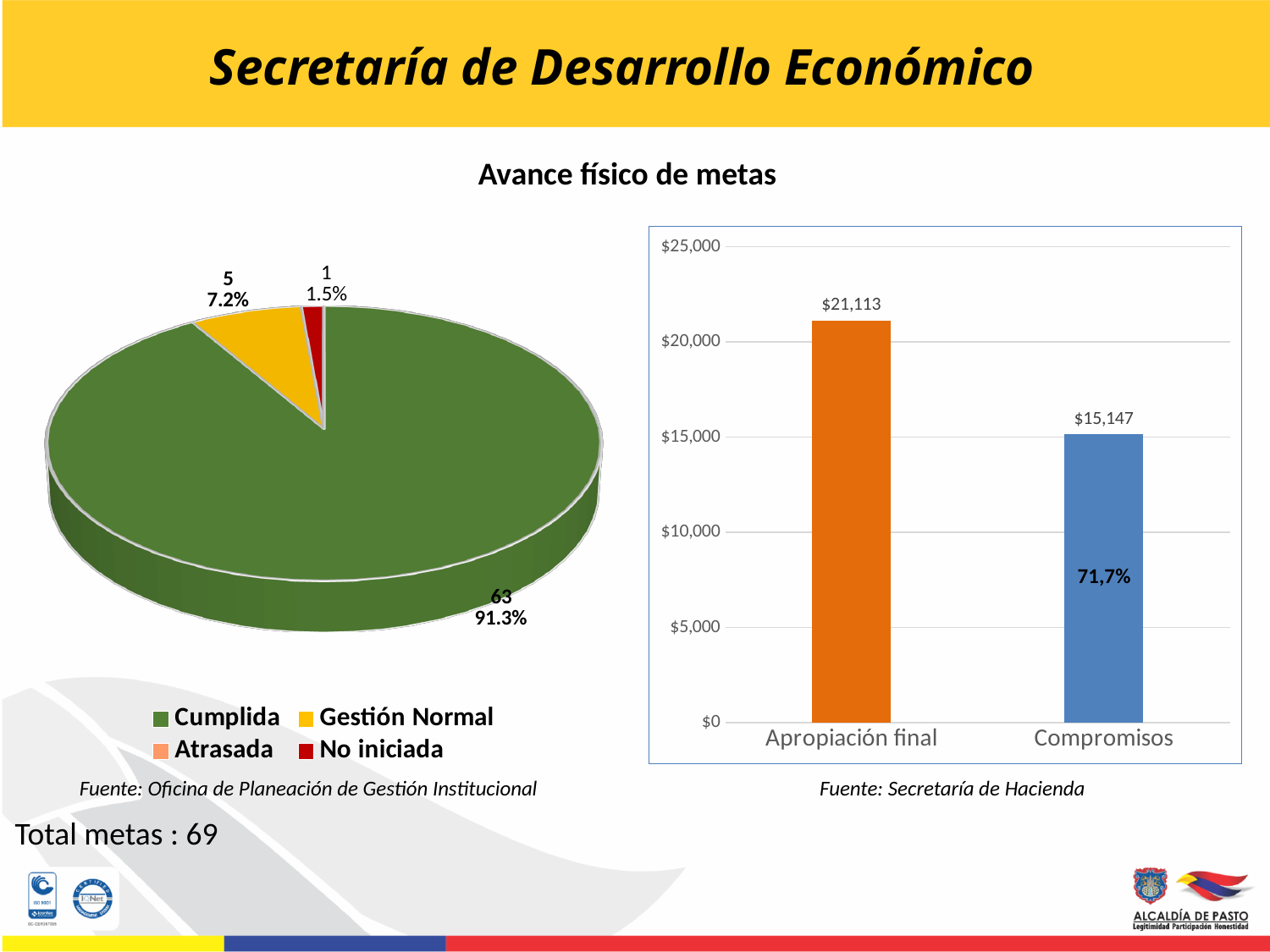
In the bar chart on the right, what is the value for Apropiación final? $21,113 In the bar chart on the right, what is the value for Compromisos? $15,147 In the pie chart on the left, which category has the largest slice? Cumplida In the bar chart on the right, which category has the higher value, Apropiación final or Compromisos? Apropiación final What kind of chart is the chart on the left of the slide? Pie chart In the pie chart on the left, what percentage share does the Cumplida slice have? 91.3% In the bar chart on the right, what is the difference between Apropiación final and Compromisos? $5,966 In the bar chart on the right, what percentage is printed on the Compromisos bar? 71,7% In the pie chart on the left, how many entries does the legend list? 4 In the pie chart on the left, what percentage share does the Gestión Normal slice have? 7.2% In the pie chart on the left, what is the count shown for the No iniciada slice? 1 In the pie chart on the left, how many metas are labelled Cumplida? 63